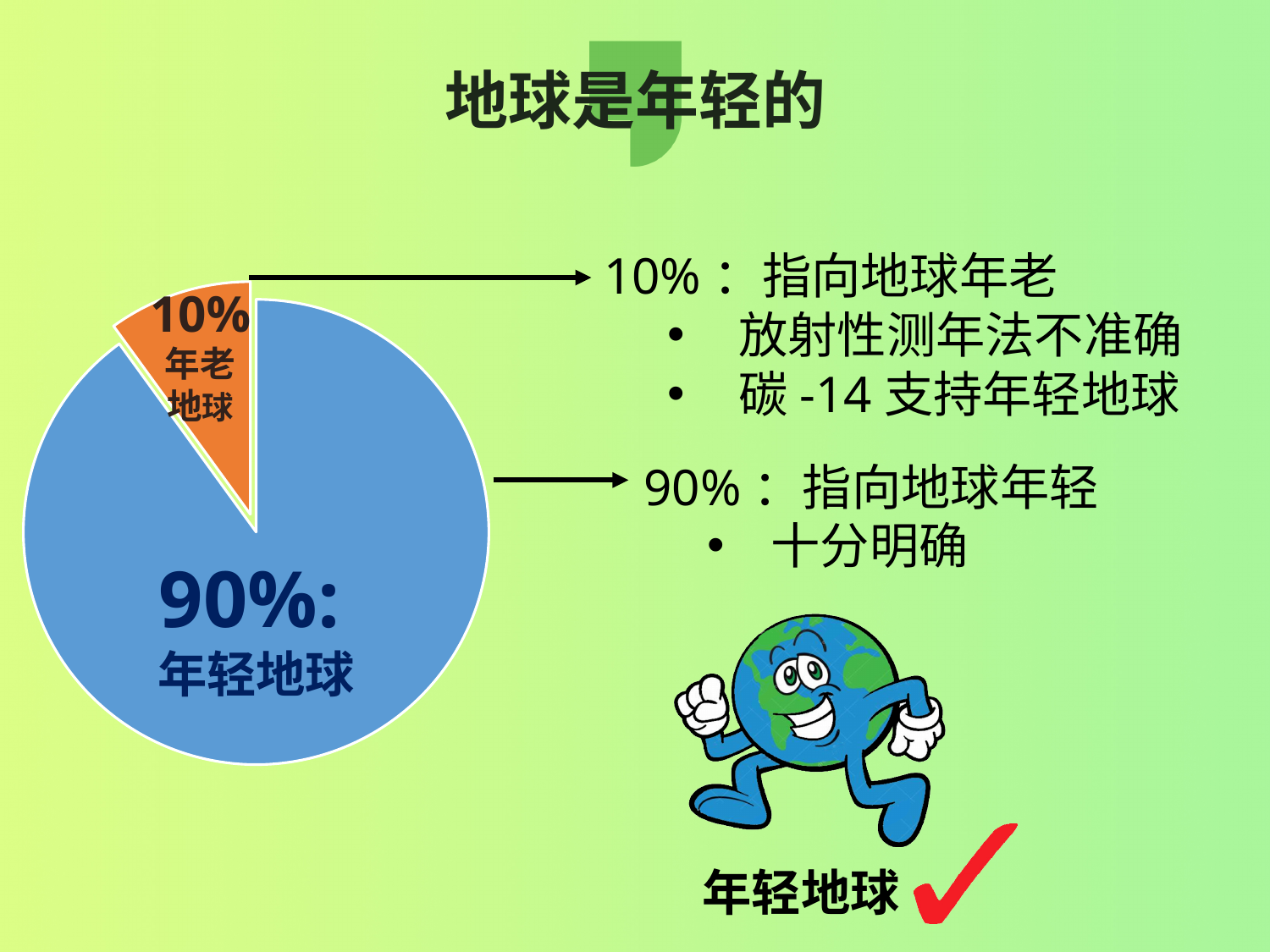
Which slice of the pie is the largest? 年轻地球 What is the difference between the 年轻地球 share and the 年老地球 share? 80% What share of the pie does 年老地球 represent? 10% What is the total of the two slices shown in the pie chart? 100% What colour is the 年轻地球 slice? blue Which slice of the pie is the smallest? 年老地球 What kind of chart is shown on the slide? pie chart Which is larger, the 年老地球 slice or the 年轻地球 slice? 年轻地球 What colour is the 年老地球 slice? orange What share of the pie does 年轻地球 represent? 90% How many slices does the pie chart have? 2